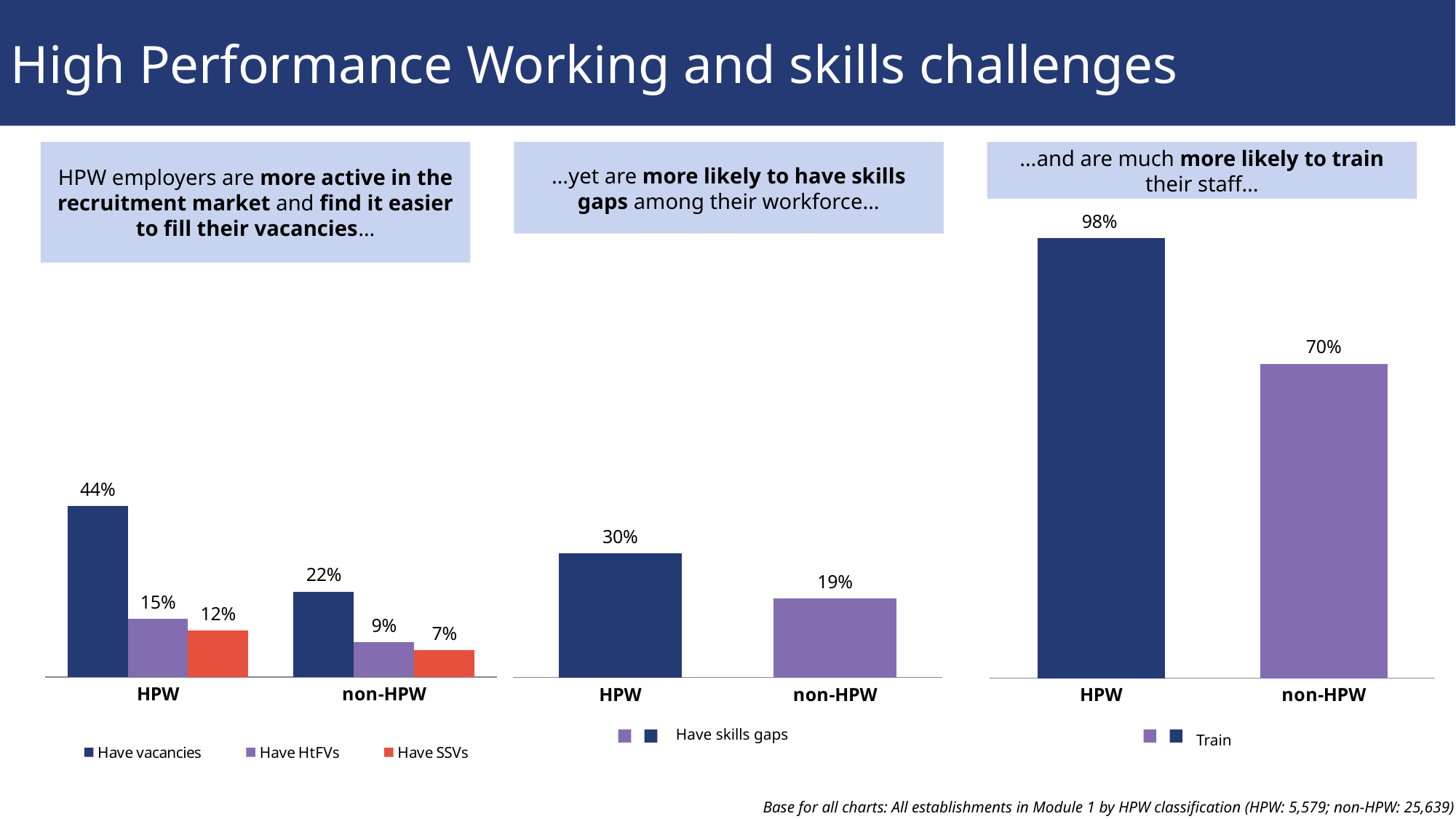
In the left chart, which series has the highest value for non-HPW employers? Have vacancies In the left chart, what percentage of non-HPW employers have SSVs? 7% In the middle chart, what is the difference between HPW and non-HPW employers that have skills gaps? 11% In the left chart, what is the difference between HPW and non-HPW employers that have HtFVs? 6% In the right chart, what is the difference between the HPW and non-HPW values for Train? 28% In the right chart, what percentage of HPW employers train their staff? 98% What kind of chart is the right chart? Bar chart In the left chart, how many series does the legend list? 3 In the middle chart, what percentage of non-HPW employers have skills gaps? 19% In the middle chart, which group has the higher share with skills gaps, HPW or non-HPW? HPW In the left chart, what percentage of HPW employers have vacancies? 44% How many categories are shown on the x axis of the middle chart? 2